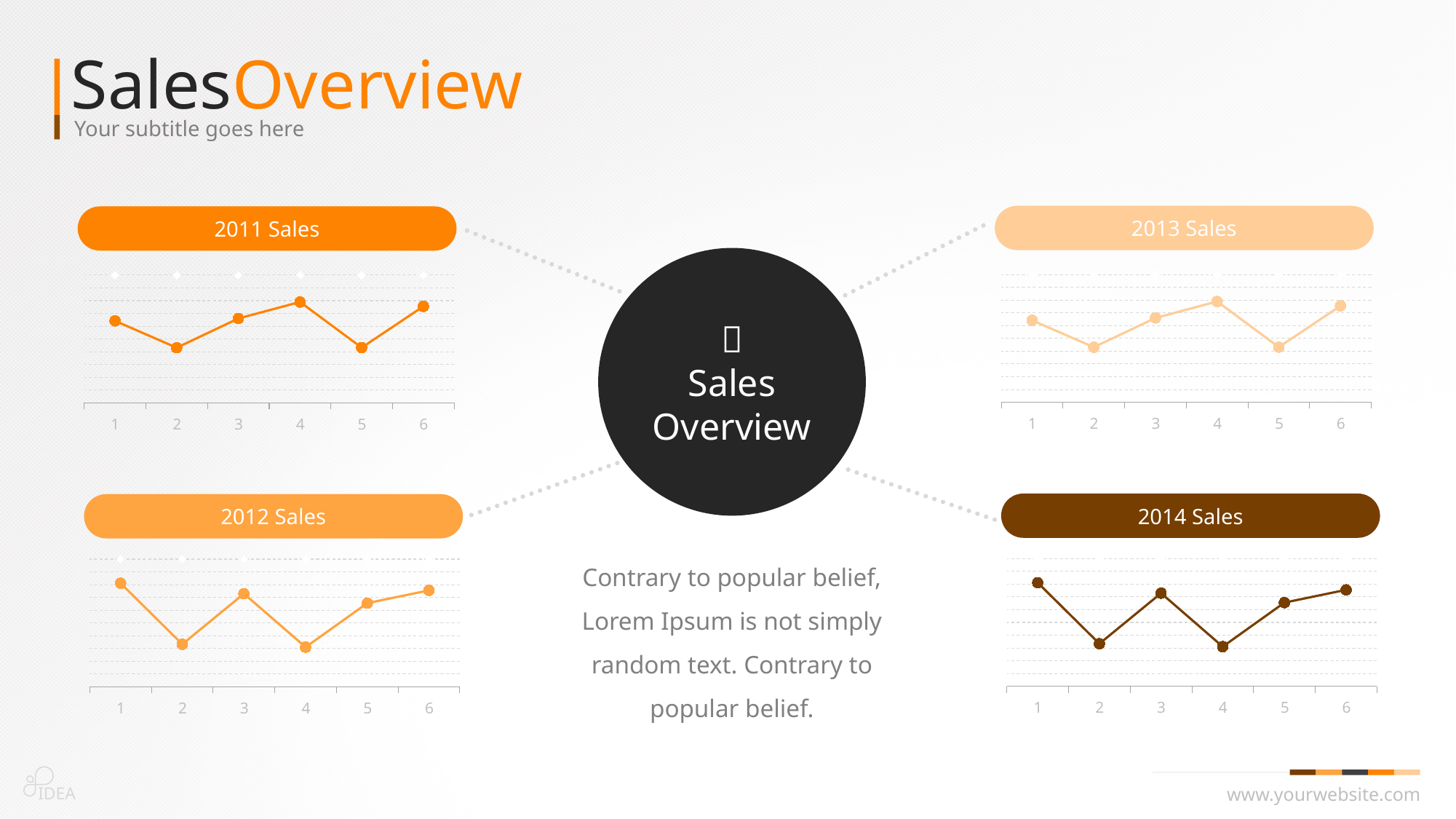
On the 2013 Sales chart, which x-axis category has the highest value? 4 On the 2014 Sales chart, is the value at 1 larger or smaller than the value at 2? larger On the 2014 Sales chart, does the value rise or fall from 4 to 5? rise On the 2012 Sales chart, which x-axis category has the highest value? 1 On the 2012 Sales chart, does the value rise or fall from 1 to 2? fall On the 2011 Sales chart, is the value at 4 larger or smaller than the value at 2? larger How many data points are plotted on the 2011 Sales chart? 6 How many x-axis categories does the 2014 Sales chart have? 6 On the 2011 Sales chart, which x-axis category has the highest value? 4 On the 2013 Sales chart, is the value at 5 larger or smaller than the value at 6? smaller What kind of chart is the 2011 Sales chart? line chart How many sales charts are shown on the slide? 4